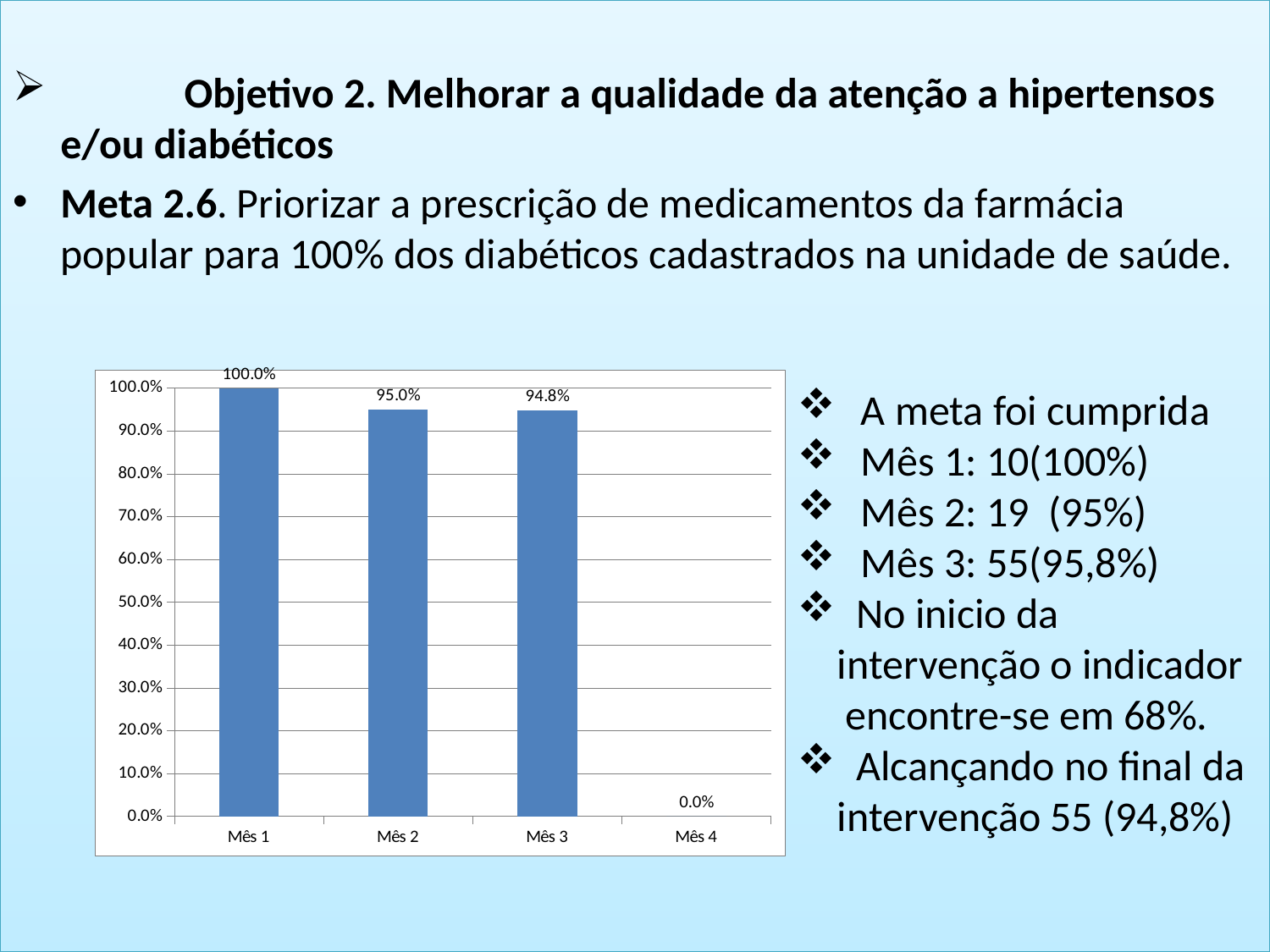
How many categories are shown on the x axis? 4 What is the value for Mês 2? 95.0% What kind of chart is shown on the slide? bar chart Which category has the highest value? Mês 1 What is the difference between the values for Mês 1 and Mês 2? 5.0% Which category has the lowest value? Mês 4 Which is larger, the value for Mês 1 or the value for Mês 3? Mês 1 What is the value for Mês 1? 100.0% What is the difference between the values for Mês 2 and Mês 3? 0.2% What is the value for Mês 4? 0.0% Is the value for Mês 2 greater or less than 90.0%? greater What is the value for Mês 3? 94.8%